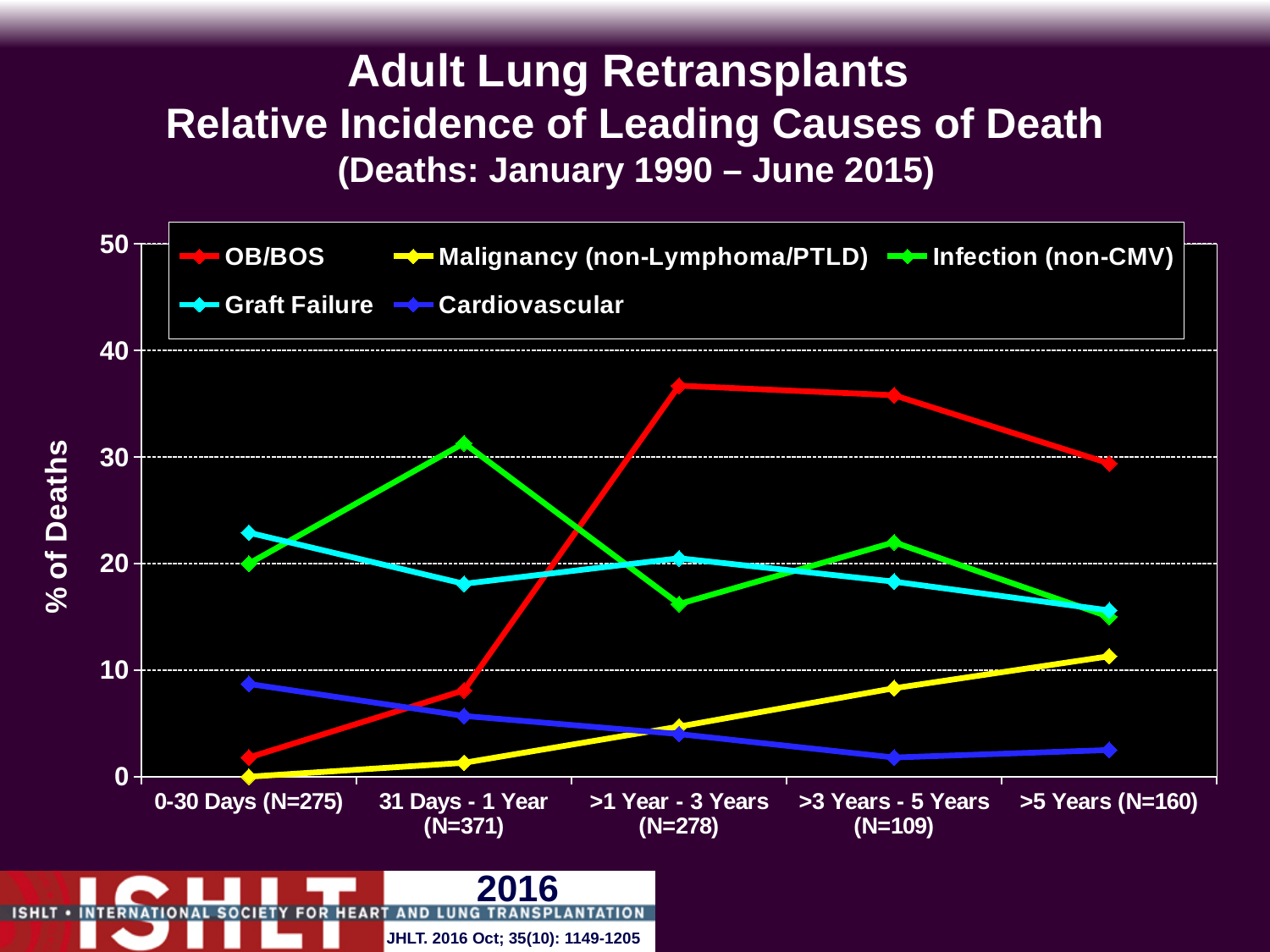
Is the value for Infection (non-CMV) in the 31 Days - 1 Year period greater or less than 20? greater How many time-period categories are shown on the x axis? 5 Which cause of death has the lowest % of deaths in the 0-30 Days period? Malignancy (non-Lymphoma/PTLD) Does the Malignancy (non-Lymphoma/PTLD) line rise or fall from 0-30 Days to >5 Years? rise Is the value for OB/BOS in the >1 Year - 3 Years period greater or less than 30? greater What kind of chart is shown on the slide? line chart Which cause of death has the highest % of deaths in the >1 Year - 3 Years period? OB/BOS Is the value for Cardiovascular in the >3 Years - 5 Years period greater or less than 10? less In the >5 Years period, which is larger: OB/BOS or Infection (non-CMV)? OB/BOS Which cause of death has the highest % of deaths in the 0-30 Days period? Graft Failure Does the OB/BOS line rise or fall from >1 Year - 3 Years to >5 Years? fall How many series does the legend list? 5